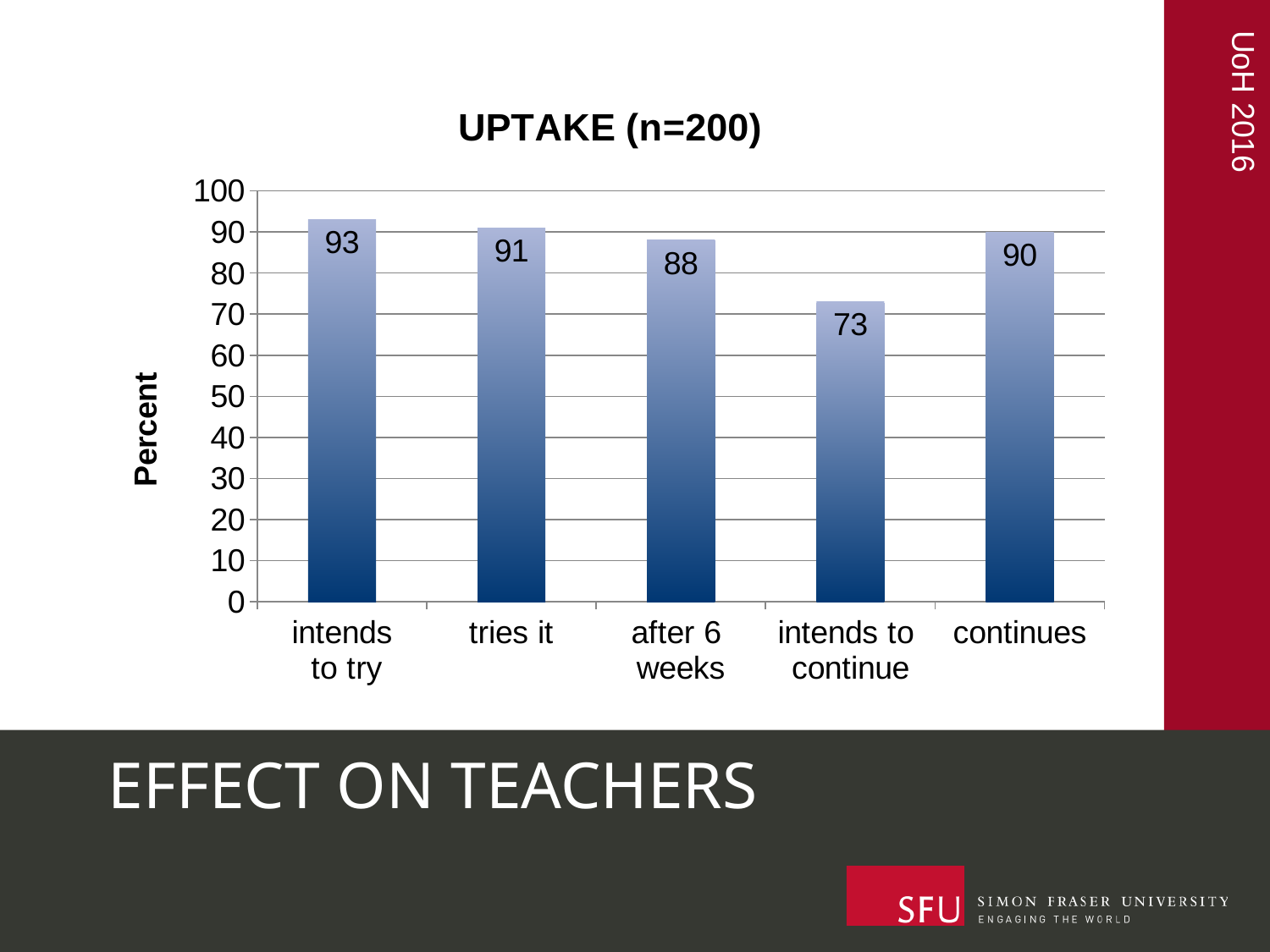
Which is larger, 'tries it' or 'continues'? tries it What is the value for 'intends to try'? 93 What is the label of the y axis? Percent What is the value for 'after 6 weeks'? 88 How many categories are shown on the x axis? 5 What is the difference between 'intends to try' and 'intends to continue'? 20 Which category has the lowest value? intends to continue What is the value for 'intends to continue'? 73 Is the value for 'intends to continue' greater or less than 80? less Which category has the highest value? intends to try What kind of chart is this? bar chart What is the title of the chart? UPTAKE (n=200)